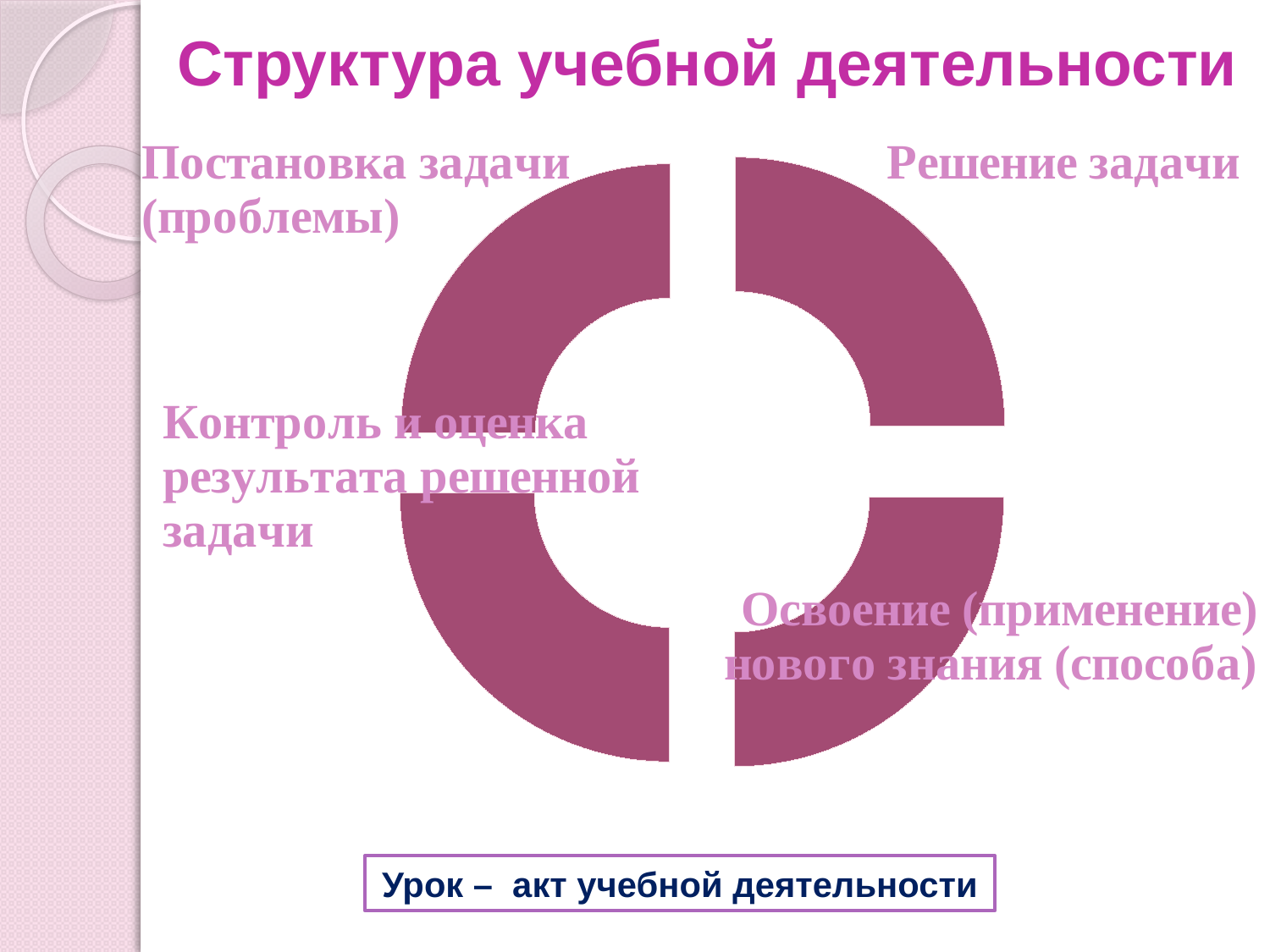
Which label is placed next to the bottom-left segment of the doughnut chart? Контроль и оценка результата решенной задачи What colour are the segments of the doughnut chart? purple Are any numeric data labels printed on the doughnut chart? no What kind of chart is shown on the slide? doughnut chart Which label is placed next to the top-right segment of the doughnut chart? Решение задачи What is the title of the slide containing the doughnut chart? Структура учебной деятельности Which label is placed next to the top-left segment of the doughnut chart? Постановка задачи (проблемы) Which label is placed next to the bottom-right segment of the doughnut chart? Освоение (применение) нового знания (способа) How many segments does the doughnut chart have? 4